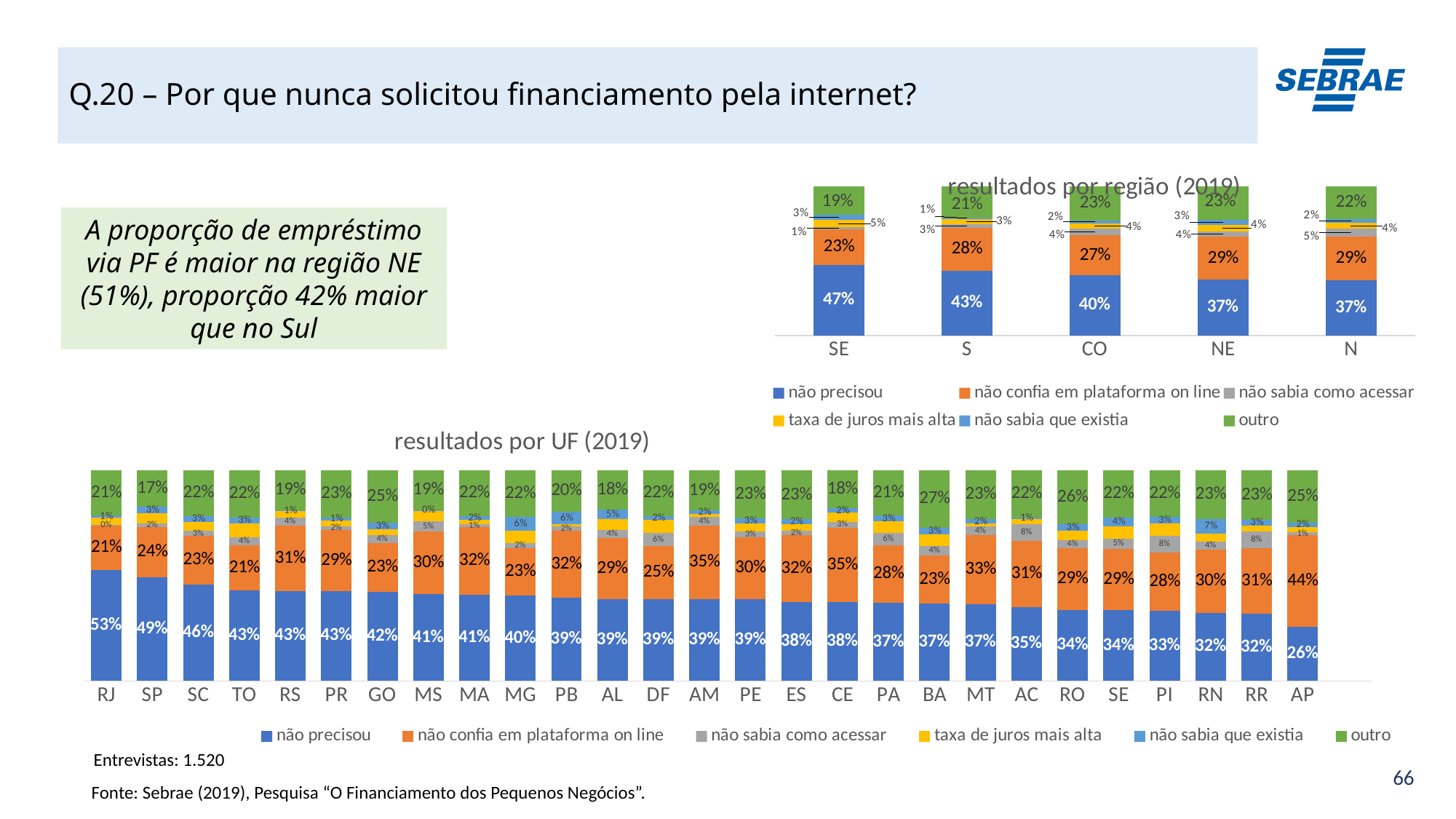
In the 'resultados por região (2019)' chart, what is the 'não confia em plataforma on line' value for NE? 29% In the 'resultados por região (2019)' chart, what is the 'não precisou' value for SE? 47% In the 'resultados por UF (2019)' chart, which UF has the lowest 'não precisou' value? AP In the 'resultados por região (2019)' chart, what is the difference between the 'não precisou' values for SE and N? 10% In the 'resultados por região (2019)' chart, how many regions are shown on the x axis? 5 How many series does the legend of the 'resultados por UF (2019)' chart list? 6 In the 'resultados por região (2019)' chart, which region has the highest 'não precisou' value? SE In the 'resultados por UF (2019)' chart, what is the 'não precisou' value for RJ? 53% What kind of chart is 'resultados por UF (2019)'? Stacked bar chart In the 'resultados por UF (2019)' chart, how many UFs are shown on the x axis? 27 In the 'resultados por UF (2019)' chart, which is larger: the 'outro' value for BA or for SP? BA In the 'resultados por UF (2019)' chart, what is the 'não confia em plataforma on line' value for AP? 44%